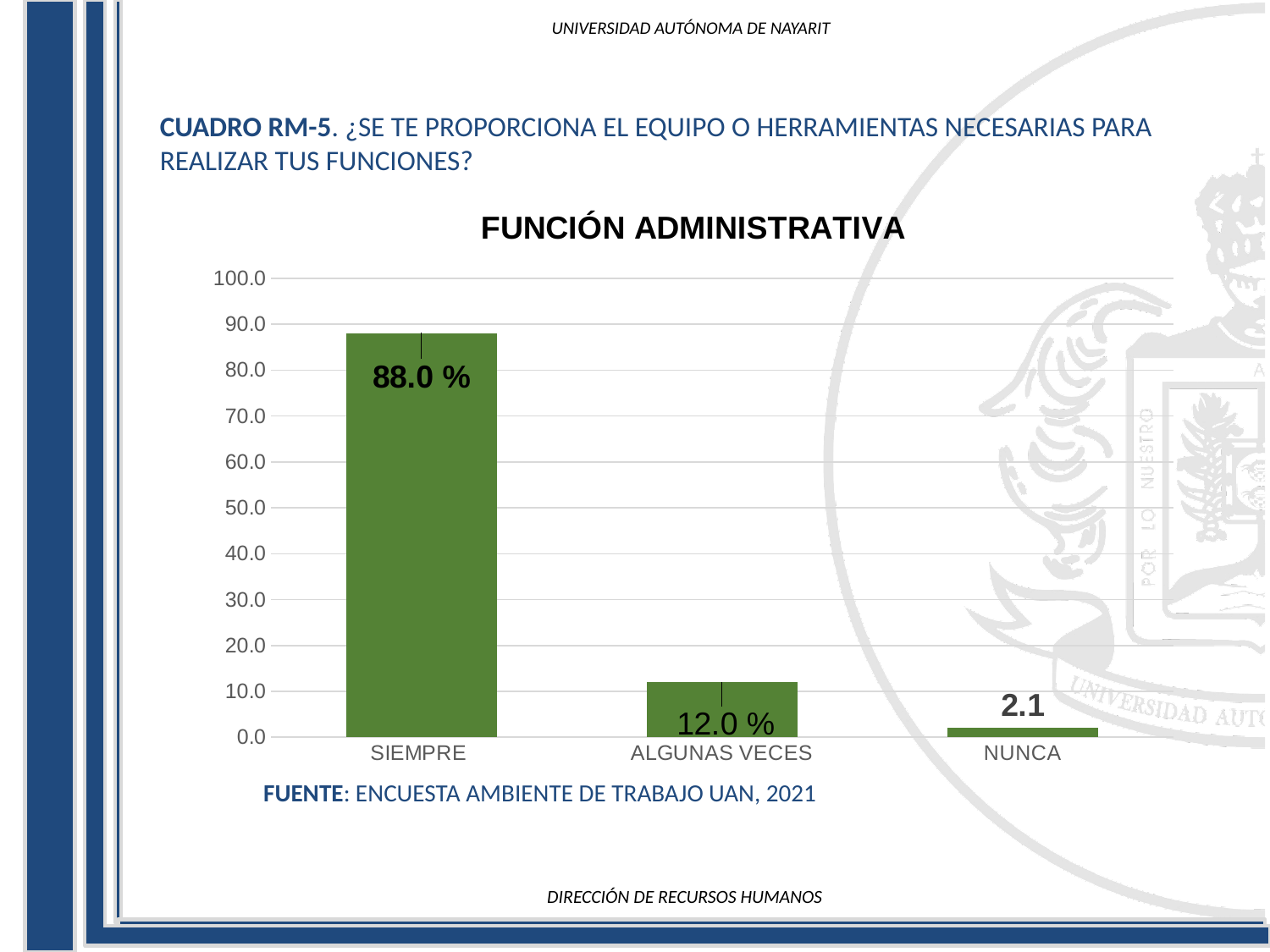
What is the difference between the values for SIEMPRE and ALGUNAS VECES? 76.0 What is the value for ALGUNAS VECES? 12.0 % Which is larger, the value for ALGUNAS VECES or the value for NUNCA? ALGUNAS VECES What kind of chart is shown? bar chart What is the value for SIEMPRE? 88.0 % Which category has the lowest value? NUNCA What is the title of the chart? FUNCIÓN ADMINISTRATIVA What is the value for NUNCA? 2.1 Is the value for SIEMPRE greater or less than 80.0? greater Is the value for NUNCA greater or less than 10.0? less Which category has the highest value? SIEMPRE How many categories are shown on the x axis? 3